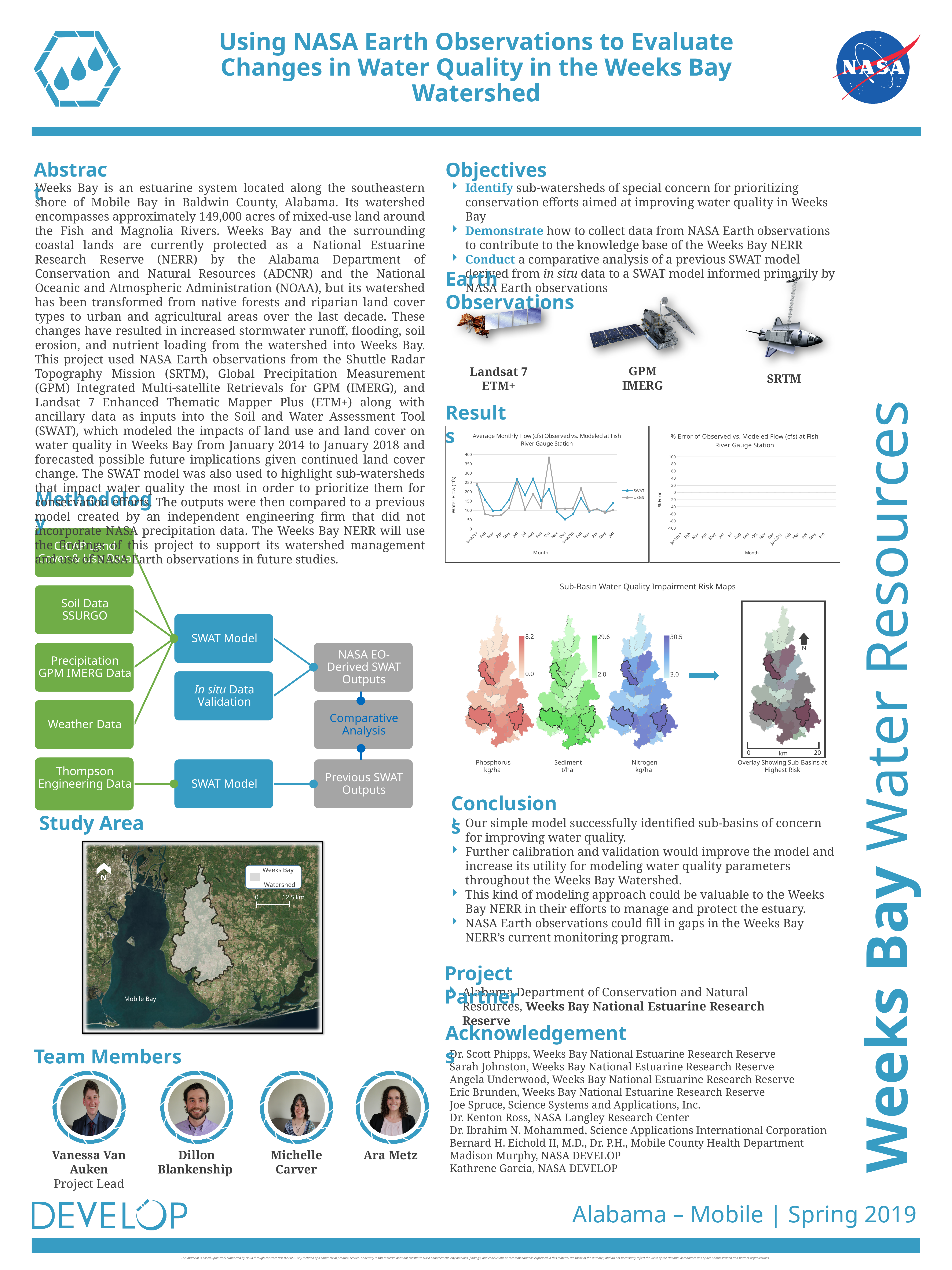
What is the y-axis title of the '% Error of Observed vs. Modeled Flow (cfs) at Fish River Gauge Station' chart? % Error What is the y-axis title of the 'Average Monthly Flow (cfs) Observed vs. Modeled at Fish River Gauge Station' chart? Water Flow (cfs) In the 'Average Monthly Flow (cfs) Observed vs. Modeled at Fish River Gauge Station' chart, which series has the larger value in Oct, SWAT or USGS? USGS How many months are shown along the x axis of the 'Average Monthly Flow (cfs) Observed vs. Modeled at Fish River Gauge Station' chart? 18 What are the two series named in the legend of the 'Average Monthly Flow (cfs) Observed vs. Modeled at Fish River Gauge Station' chart? SWAT and USGS How many series does the legend of the 'Average Monthly Flow (cfs) Observed vs. Modeled at Fish River Gauge Station' chart list? 2 In the 'Average Monthly Flow (cfs) Observed vs. Modeled at Fish River Gauge Station' chart, is the USGS value for Feb 2017 greater or less than 100? less In the 'Average Monthly Flow (cfs) Observed vs. Modeled at Fish River Gauge Station' chart, in which month does the USGS series reach its highest value? Oct In the 'Average Monthly Flow (cfs) Observed vs. Modeled at Fish River Gauge Station' chart, is the SWAT value for Oct greater or less than 300? less In the 'Average Monthly Flow (cfs) Observed vs. Modeled at Fish River Gauge Station' chart, is the USGS value for Oct greater or less than 300? greater In the 'Average Monthly Flow (cfs) Observed vs. Modeled at Fish River Gauge Station' chart, which series reaches the highest value? USGS What kind of chart is the 'Average Monthly Flow (cfs) Observed vs. Modeled at Fish River Gauge Station' chart? line chart